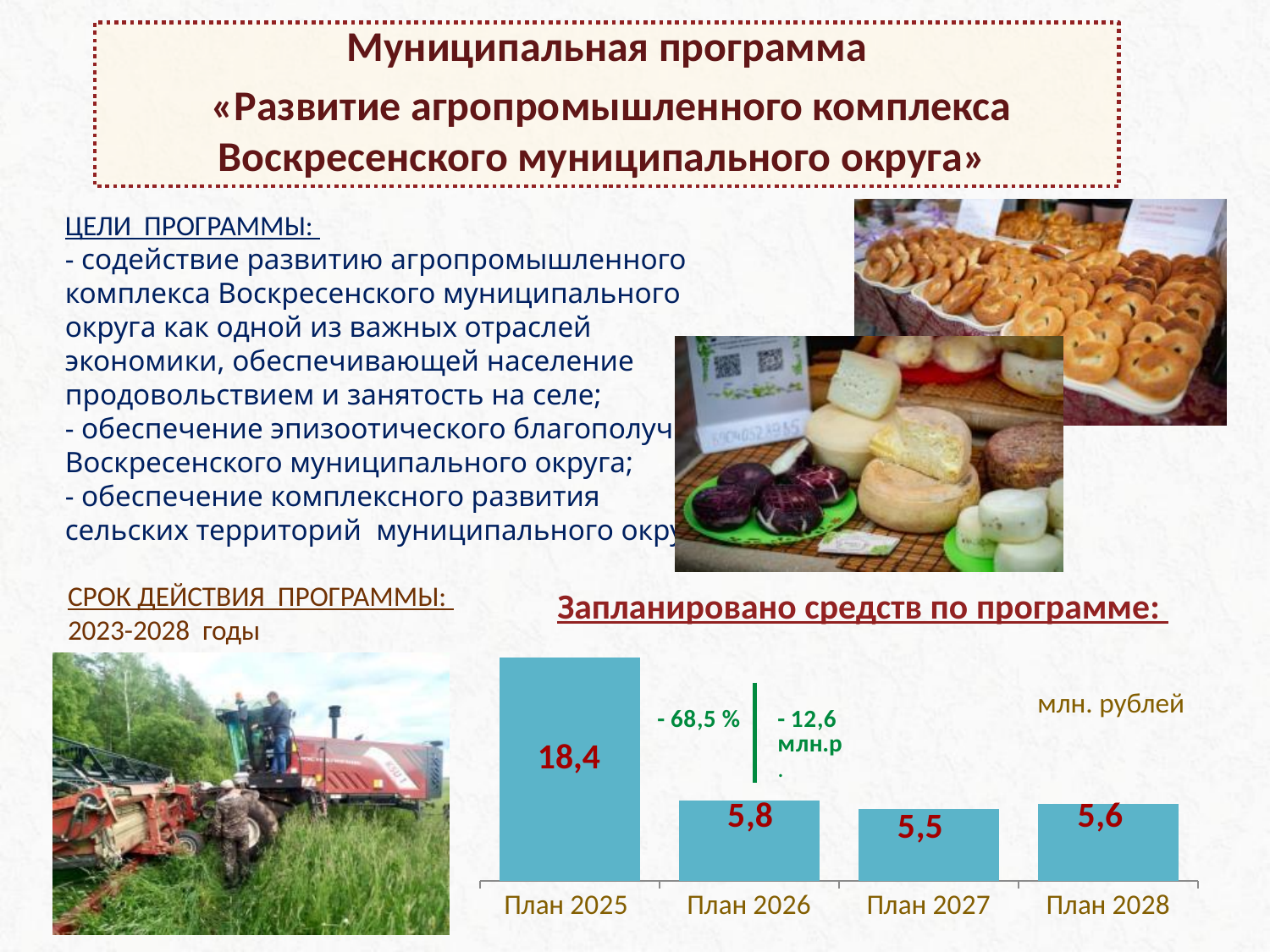
What is the difference between the planned amounts for План 2025 and План 2026? 12,6 How many years (categories) are shown in the chart? 4 Which year has the lowest planned amount? План 2027 What is the planned amount for План 2028? 5,6 Which is larger, the planned amount for План 2026 or План 2028? План 2026 What is the planned amount for План 2027? 5,5 What is the planned amount for План 2025? 18,4 Which year has the highest planned amount? План 2025 What is the planned amount for План 2026? 5,8 Do the planned amounts rise or fall from План 2025 to План 2027? Fall In what units are the chart values given? млн. рублей What kind of chart is used to show the planned funds? Bar chart